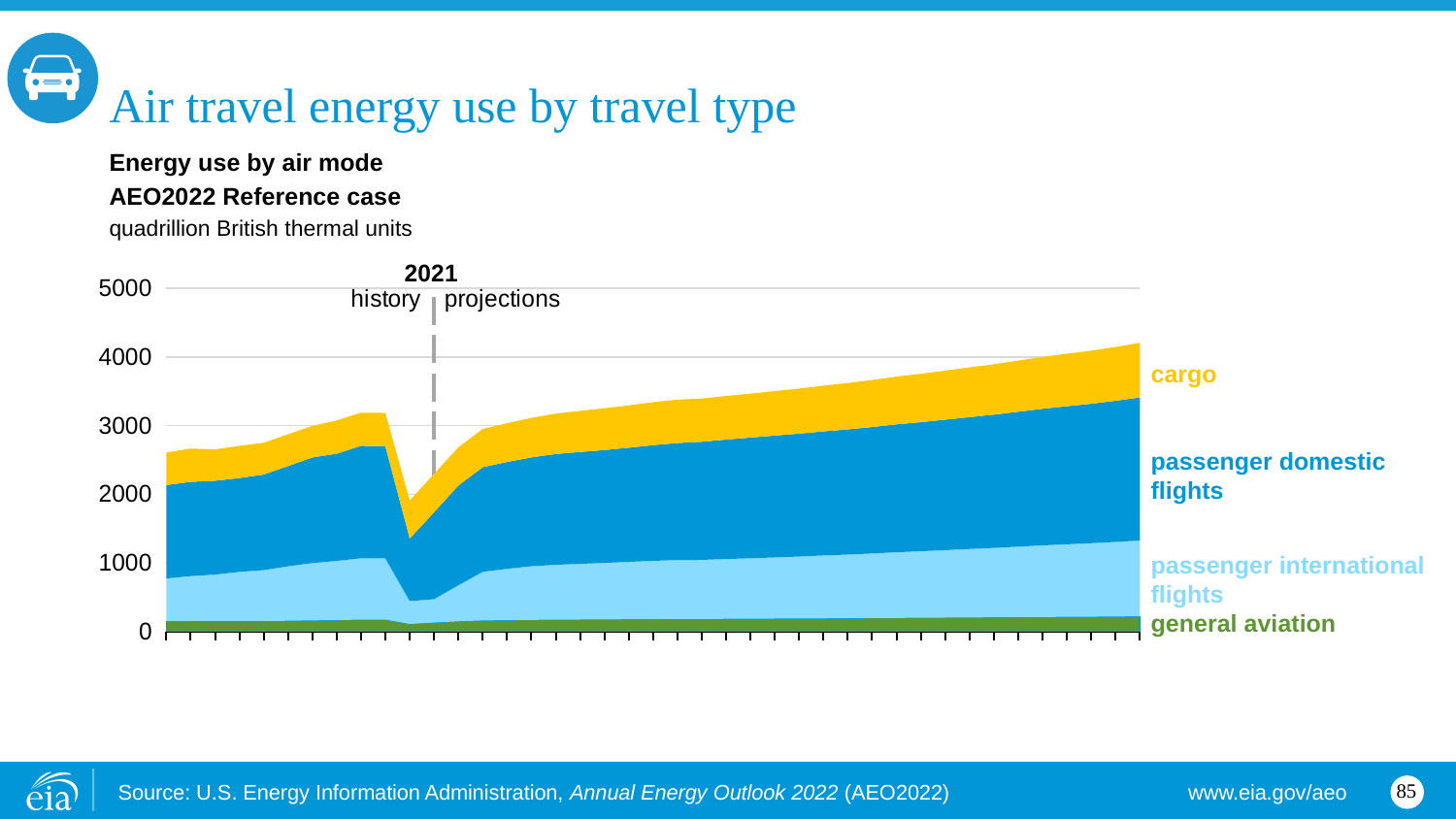
Do total air travel energy use values rise or fall over the projection period after 2021? rise How many travel types (series) are shown in the chart? 4 What year separates history from projections in the chart? 2021 Is the total air travel energy use at the start of the history period greater or less than 2000? greater Is the total air travel energy use at the 2021 dividing line greater or less than 3000? less Is the total air travel energy use at the end of the projection period greater or less than 4000? greater Which travel type accounts for the largest share of air travel energy use throughout the chart? passenger domestic flights What kind of chart is shown on the slide? stacked area chart Which travel type accounts for the smallest share of air travel energy use in the chart? general aviation Which is larger at the end of the projection period: energy use for passenger domestic flights or for cargo? passenger domestic flights What unit is the chart's energy use measured in? quadrillion British thermal units